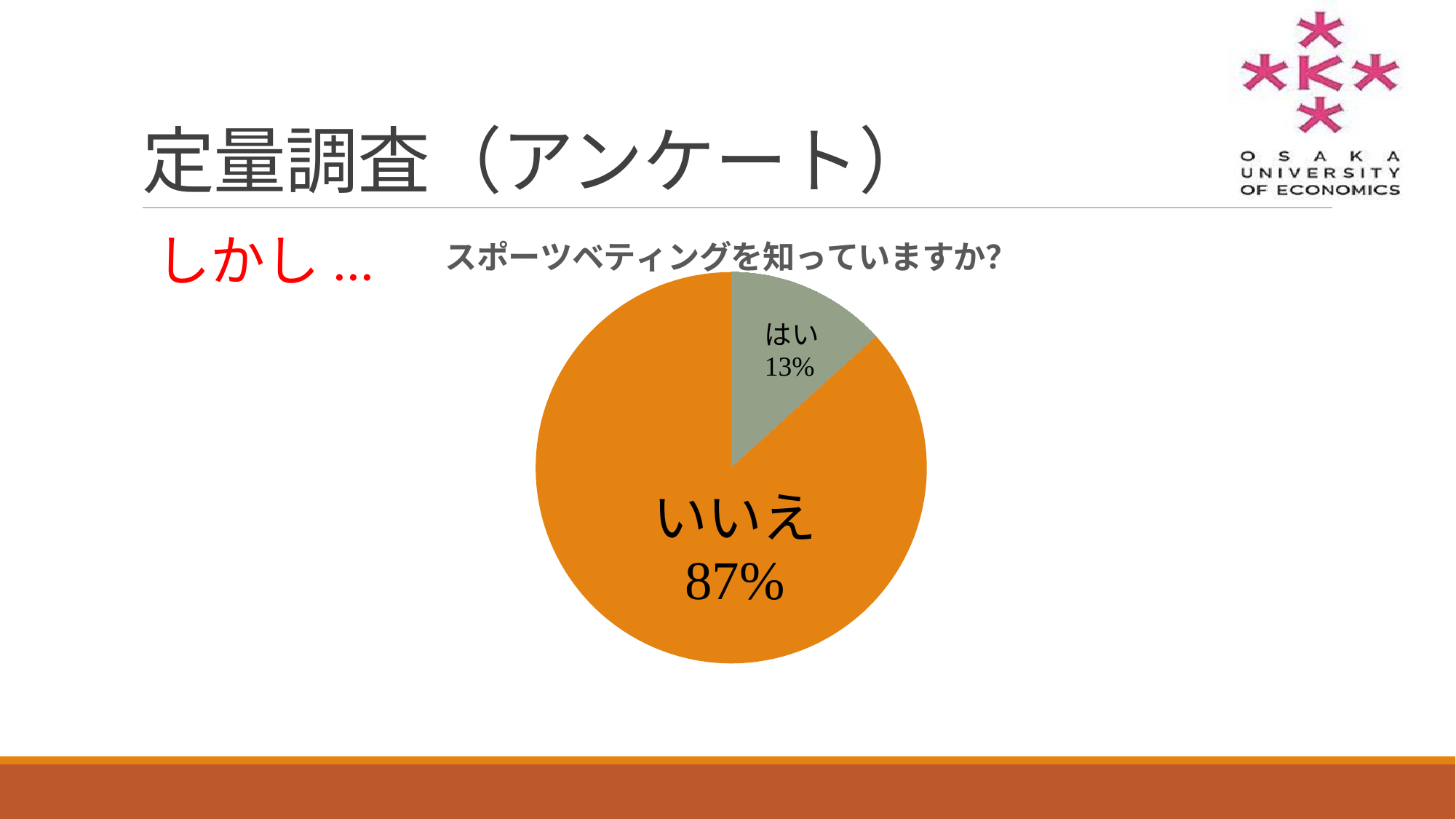
What colour is the いいえ slice of the pie? orange What is the title of the pie chart? スポーツベティングを知っていますか? Which is larger, the はい slice or the いいえ slice? いいえ What percentage of the pie is labelled はい? 13% Which slice of the pie is the largest? いいえ Which slice of the pie is the smallest? はい What share of the pie does the はい slice represent? 13% What percentage of the pie is labelled いいえ? 87% How many slices does the pie chart have? 2 What kind of chart is shown on the slide? pie chart What is the difference in percentage points between the いいえ slice and the はい slice? 74